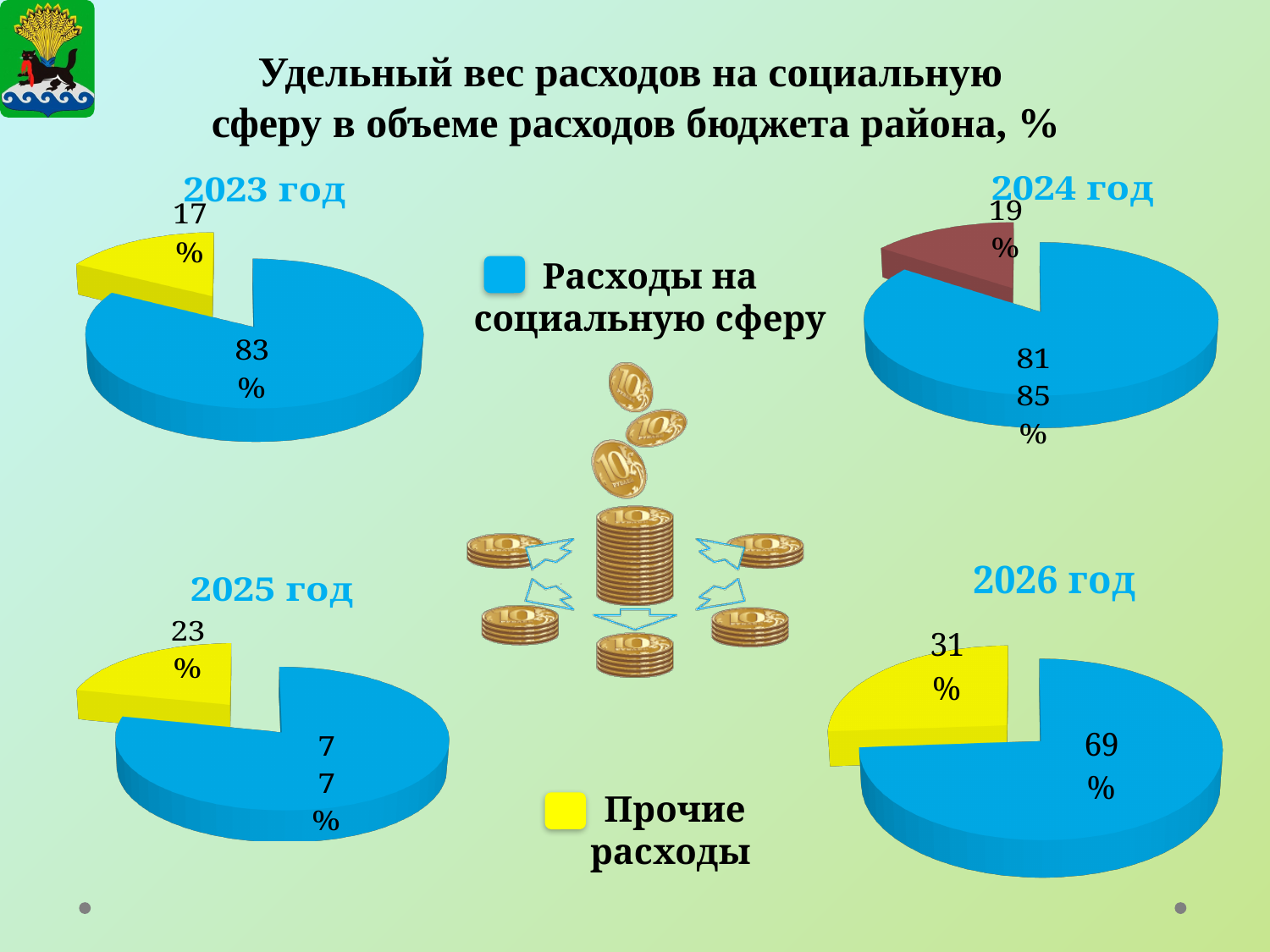
In the 2026 год pie chart, what share is shown for Прочие расходы? 31% In the 2026 год pie chart, which slice is larger: Расходы на социальную сферу or Прочие расходы? Расходы на социальную сферу In the 2025 год pie chart, what share is shown for Прочие расходы? 23% How many pie charts are shown on the slide? 4 In the 2025 год pie chart, what share is shown for Расходы на социальную сферу? 77% In the 2026 год pie chart, what share is shown for Расходы на социальную сферу? 69% What type of chart is used for each year on this slide? Pie chart In the 2023 год pie chart, what share is shown for Расходы на социальную сферу? 83% In the 2023 год pie chart, what share is shown for Прочие расходы? 17% Which colour represents Прочие расходы in the legend? Yellow In the 2024 год pie chart, what share is shown for the smaller slice (Прочие расходы)? 19% What is the difference between the Прочие расходы share in 2026 год and in 2023 год? 14%